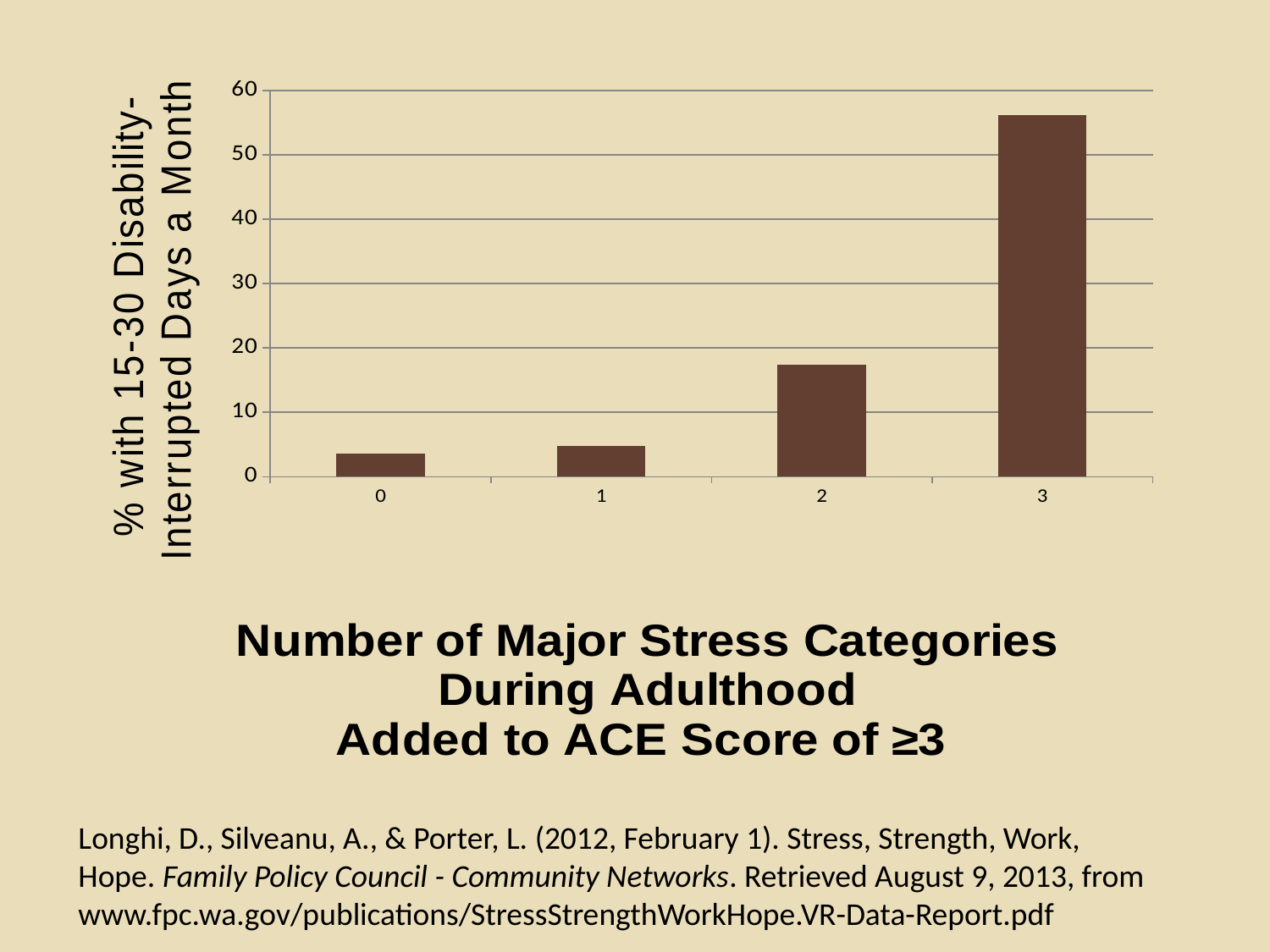
Is the value for category 0 greater or less than 10? less What is the label on the vertical axis? % with 15-30 Disability-Interrupted Days a Month Which is larger, the value for category 2 or the value for category 3? 3 Is the value for category 3 greater or less than 50? greater Is the value for category 1 greater or less than 10? less What is the highest tick value shown on the vertical axis? 60 Which category has the highest value? 3 Do the values rise or fall as the number of major stress categories increases from 0 to 3? rise What kind of chart is shown on the slide? bar chart How many categories are plotted along the x axis? 4